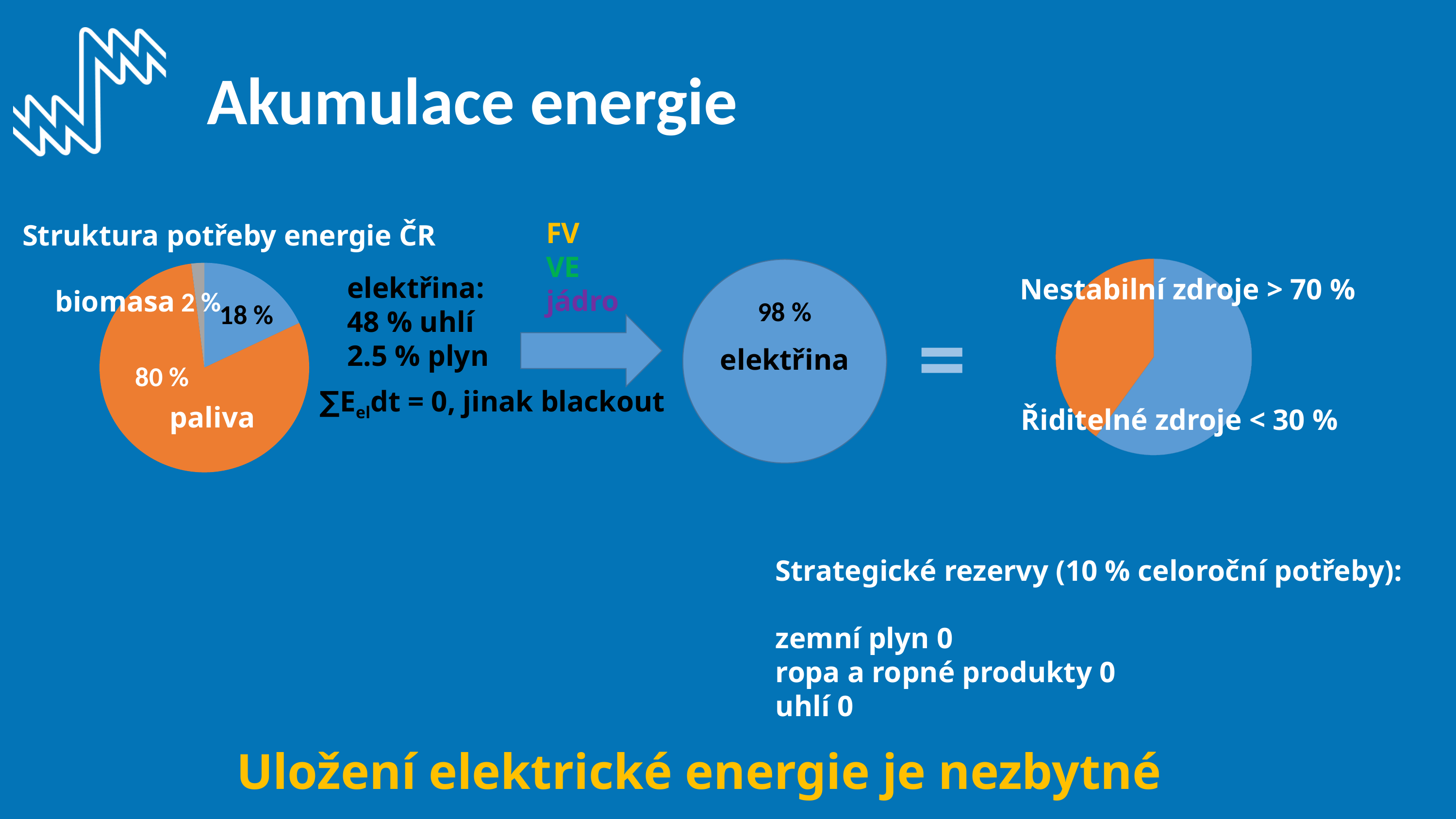
In the chart titled "Struktura potřeby energie ČR", which category has the largest slice? paliva In the chart titled "Struktura potřeby energie ČR", what is the value of the blue slice labelled 18 %? 18 % In the chart titled "Struktura potřeby energie ČR", which category has the smallest slice? biomasa What kind of chart is "Struktura potřeby energie ČR"? pie chart In the middle circular chart on the slide, what percentage is shown for elektřina? 98 % In the chart titled "Struktura potřeby energie ČR", how many slices does the pie have? 3 In the chart titled "Struktura potřeby energie ČR", what is the difference between the paliva share and the 18 % slice? 62 % In the chart titled "Struktura potřeby energie ČR", what colour is the paliva slice? orange In the chart titled "Struktura potřeby energie ČR", which is larger, the paliva slice or the biomasa slice? paliva In the pie chart on the right of the slide, which category has the larger slice, Nestabilní zdroje or Řiditelné zdroje? Nestabilní zdroje In the chart titled "Struktura potřeby energie ČR", what share does "paliva" have? 80 % In the chart titled "Struktura potřeby energie ČR", what share does "biomasa" have? 2 %